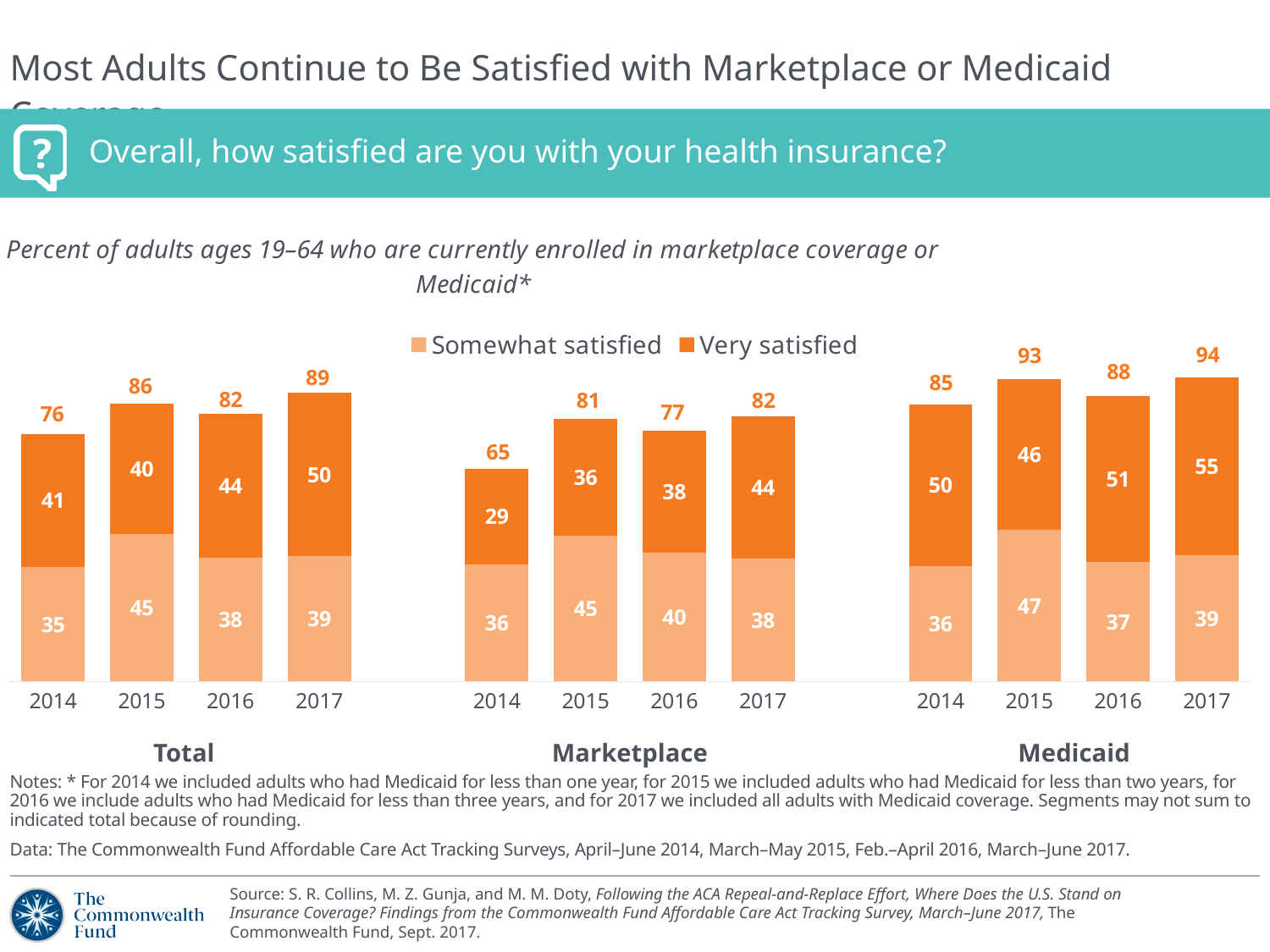
What is the 'Somewhat satisfied' value for Marketplace in 2015? 45 How many series does the legend list? 2 Which year has the highest total in the Medicaid group? 2017 Which is larger: the 'Very satisfied' value for Total in 2016 or for Marketplace in 2016? Total in 2016 What are the two legend entries in the chart? Somewhat satisfied, Very satisfied What is the difference between the 'Very satisfied' values for Medicaid in 2017 and Marketplace in 2017? 11 What is the total printed above the Total bar for 2014? 76 What kind of chart is shown on the slide? Stacked bar chart Which year has the lowest total in the Marketplace group? 2014 Does the total for the Marketplace group rise or fall from 2014 to 2015? Rise How many bars are plotted in the chart in total? 12 What is the 'Very satisfied' value for Medicaid in 2017? 55